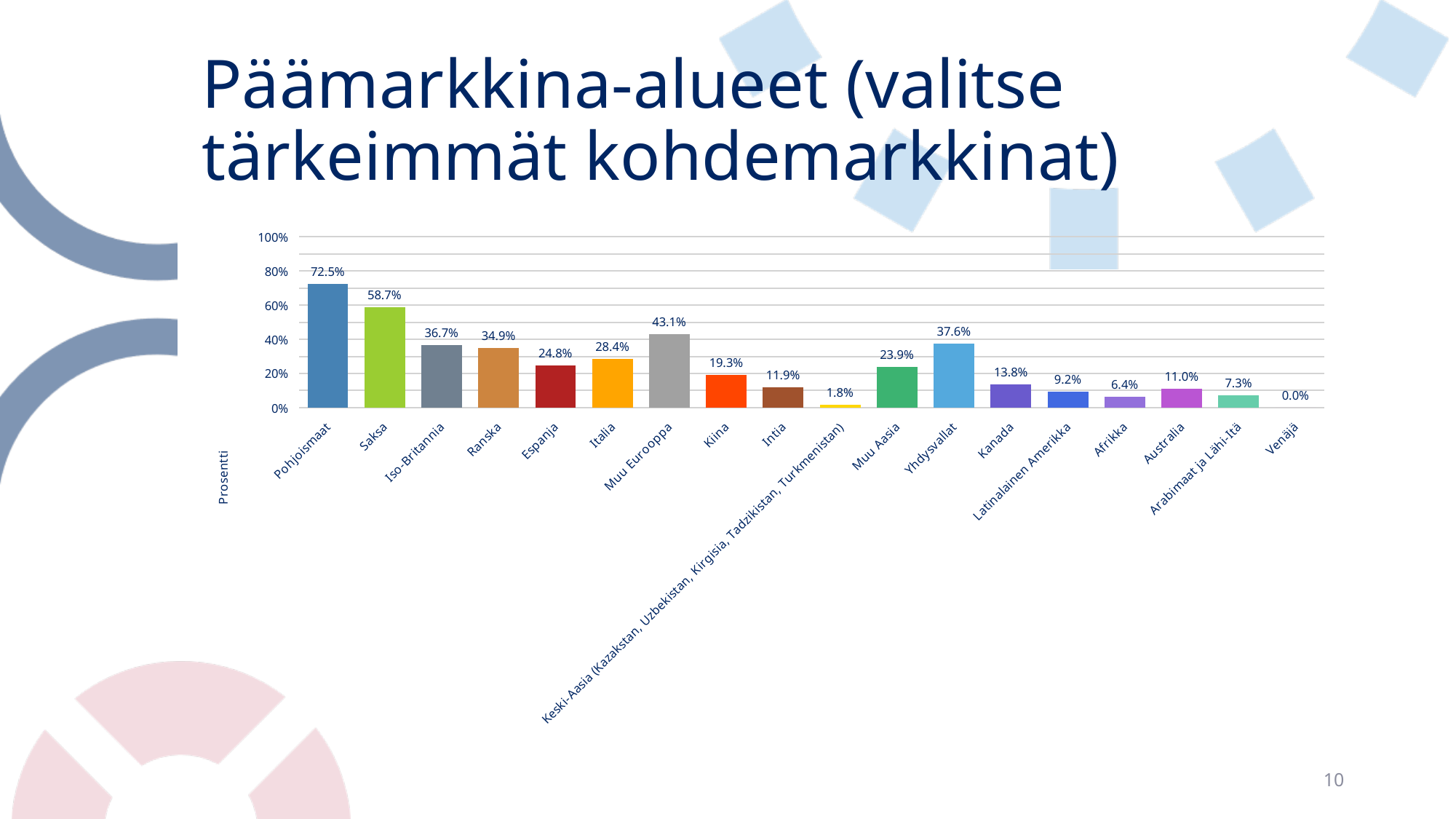
What is the label of the vertical axis? Prosentti What is the value for Venäjä? 0.0% What is the value for Muu Eurooppa? 43.1% Which category has the highest value? Pohjoismaat What is the difference between the values for Pohjoismaat and Saksa? 13.8% Is the value for Iso-Britannia greater or less than 40%? less What kind of chart is shown on the slide? bar chart Which is larger, the value for Kiina or the value for Muu Aasia? Muu Aasia Which category has the lowest value? Venäjä What is the value for Pohjoismaat? 72.5% How many categories are shown on the x axis? 18 What is the value for Yhdysvallat? 37.6%